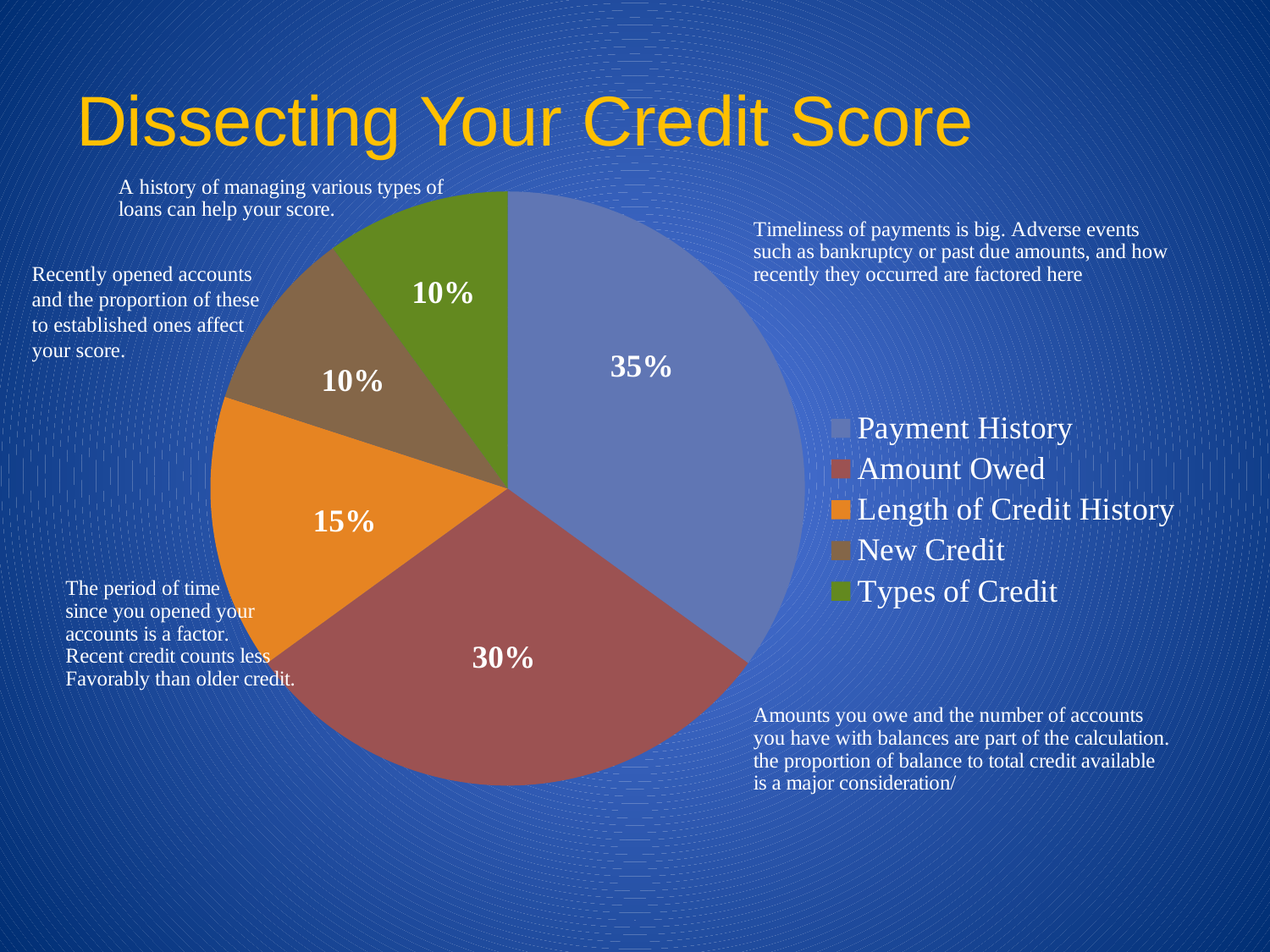
What share of the pie does Payment History represent? 35% What share of the pie does Amount Owed represent? 30% What share of the pie does New Credit represent? 10% Which category has the largest slice of the pie? Payment History Which is larger, the share for Length of Credit History or the share for New Credit? Length of Credit History What is the combined share of Payment History and Amount Owed? 65% How many categories does the pie chart show? 5 Which legend entry is shown in orange? Length of Credit History What is the difference between the Payment History share and the Amount Owed share? 5% What kind of chart is shown on the slide? pie chart